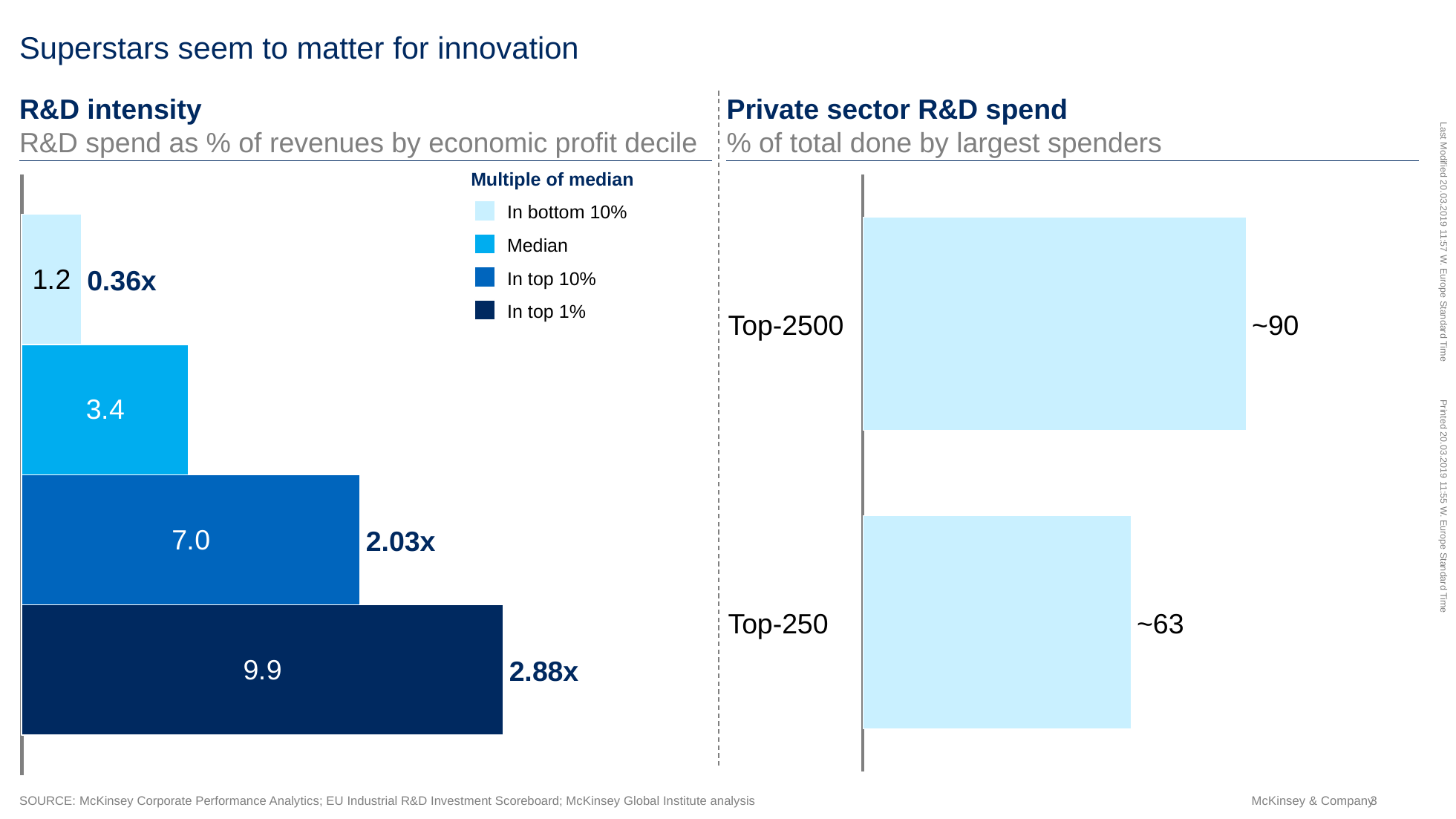
In the R&D intensity chart, which category has the lowest value? In bottom 10% In the R&D intensity chart, what is the difference between the top 1% value and the top 10% value? 2.9 In the Private sector R&D spend chart, which group has the larger share of total R&D spend, Top-2500 or Top-250? Top-2500 In the R&D intensity chart, what is the value for the Median bar? 3.4 In the R&D intensity chart, what multiple of the median is shown for companies in the top 10%? 2.03x In the R&D intensity chart, what is the value for companies in the bottom 10%? 1.2 What is the subtitle of the R&D intensity chart? R&D spend as % of revenues by economic profit decile In the Private sector R&D spend chart, what value is labelled for Top-2500? ~90 In the R&D intensity chart, how many categories does the legend list? 4 In the R&D intensity chart, what is the R&D spend as % of revenues for companies in the top 1%? 9.9 What kind of chart is the Private sector R&D spend chart? Bar chart In the R&D intensity chart, which category has the highest R&D spend as % of revenues? In top 1%